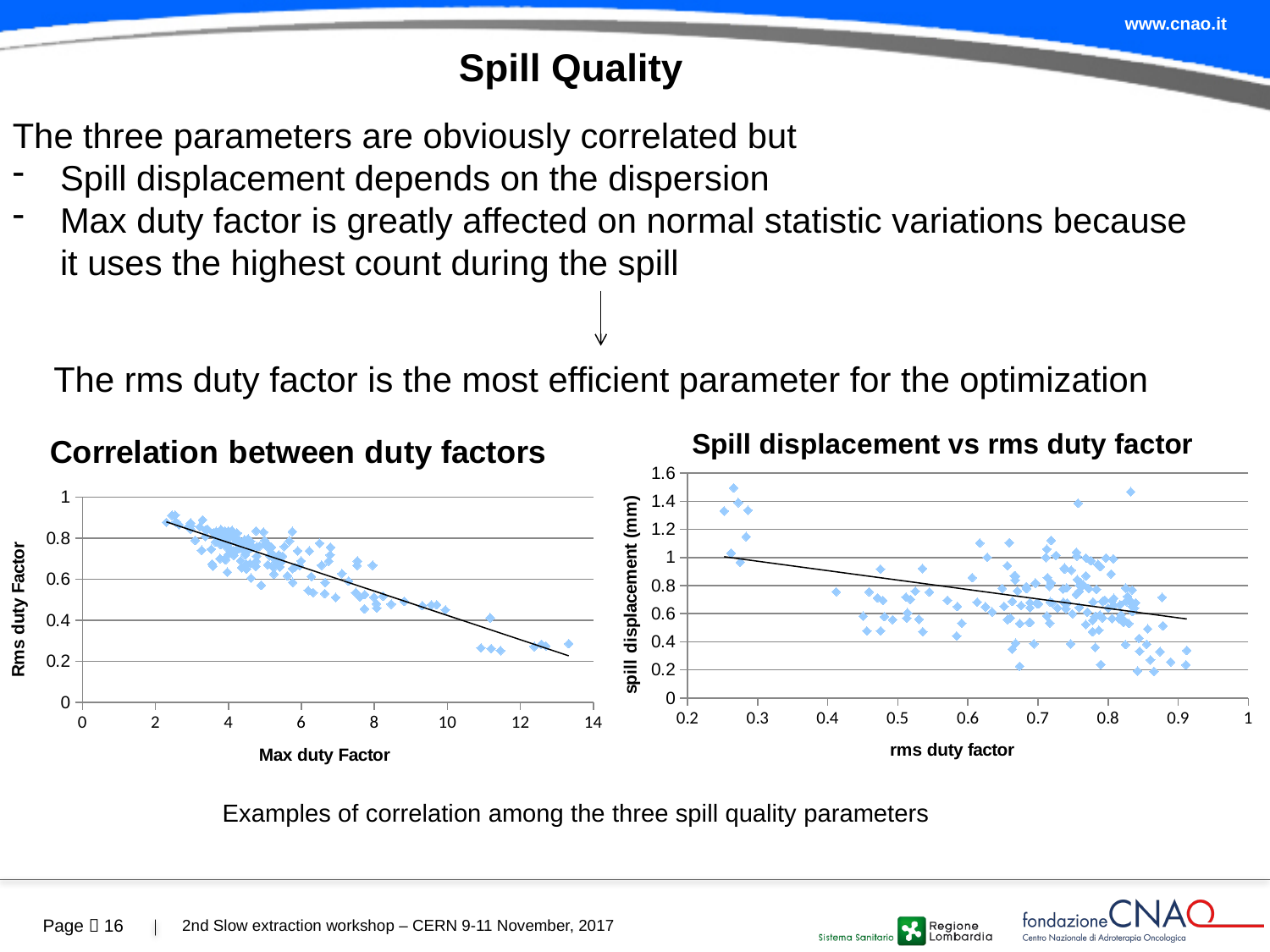
What kind of chart is the 'Correlation between duty factors' chart? scatter chart In the 'Correlation between duty factors' chart, is the Rms duty Factor of the points near a Max duty Factor of 13 greater or less than 0.4? less In the 'Spill displacement vs rms duty factor' chart, does the spill displacement rise or fall as the rms duty factor increases? fall In the 'Spill displacement vs rms duty factor' chart, is the highest plotted spill displacement greater or less than 1.4? greater How many charts are shown on the slide? 2 What is the y-axis title of the 'Spill displacement vs rms duty factor' chart? spill displacement (mm) What kind of chart is the 'Spill displacement vs rms duty factor' chart? scatter chart In the 'Correlation between duty factors' chart, is the highest plotted Rms duty Factor greater or less than 0.8? greater What is the x-axis title of the 'Correlation between duty factors' chart? Max duty Factor In the 'Correlation between duty factors' chart, does the Rms duty Factor rise or fall as the Max duty Factor increases? fall